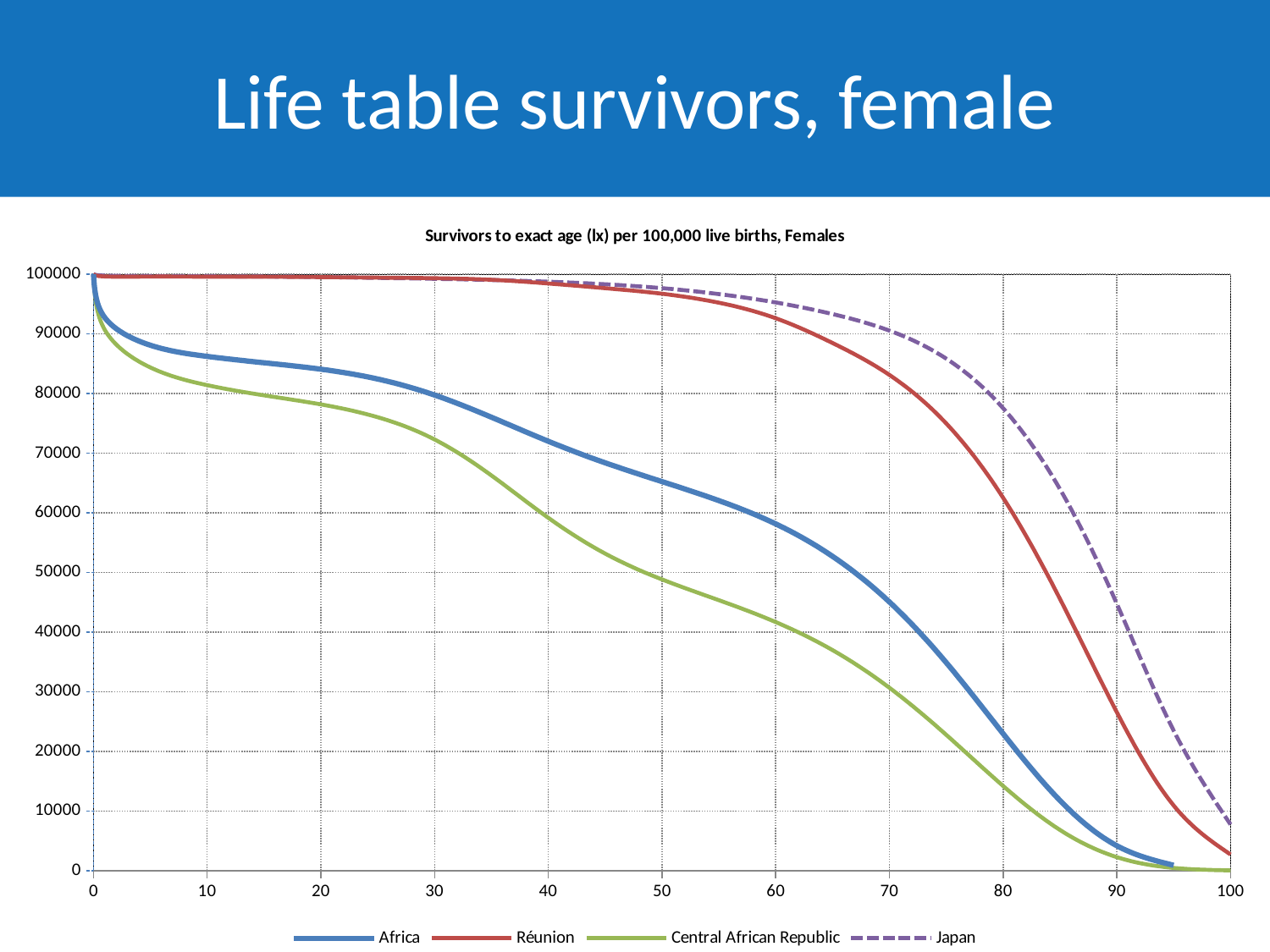
Which series has the lowest value at age 50? Central African Republic Is the value for Central African Republic at age 30 greater or less than 70000? greater How many series does the legend list? 4 Is the value for Japan at age 60 greater or less than 90000? greater Which series has the highest value at age 80? Japan Is the value for Réunion at age 70 greater or less than 80000? greater Do the values for each series rise or fall as age increases along the x axis? fall Which series is drawn with a dashed line? Japan What kind of chart is shown on the slide? line chart Which series are listed in the legend? Africa, Réunion, Central African Republic, Japan At age 60, which series has the higher value, Africa or Central African Republic? Africa